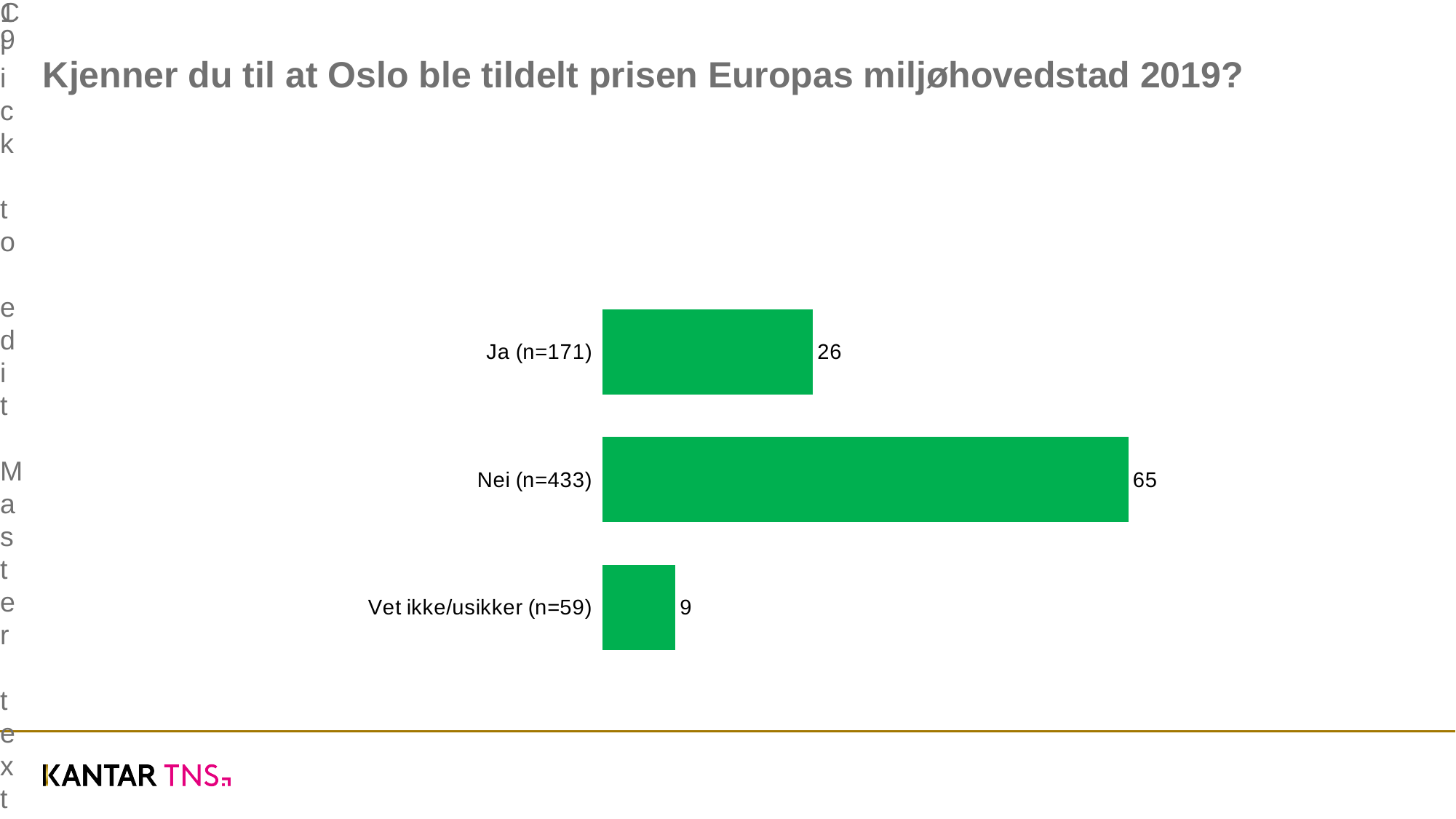
What is the value for Vet ikke/usikker (n=59)? 9 What is the difference between the values for Nei (n=433) and Ja (n=171)? 39 What colour are the bars in the chart? Green Which category has the lowest value? Vet ikke/usikker (n=59) What is the title of the slide? Kjenner du til at Oslo ble tildelt prisen Europas miljøhovedstad 2019? How many categories are shown in the chart? 3 What is the difference between the values for Ja (n=171) and Vet ikke/usikker (n=59)? 17 What is the value for Ja (n=171)? 26 Which is larger, the value for Ja (n=171) or the value for Vet ikke/usikker (n=59)? Ja (n=171) What is the value for Nei (n=433)? 65 Which category has the highest value? Nei (n=433) What kind of chart is shown on the slide? Bar chart